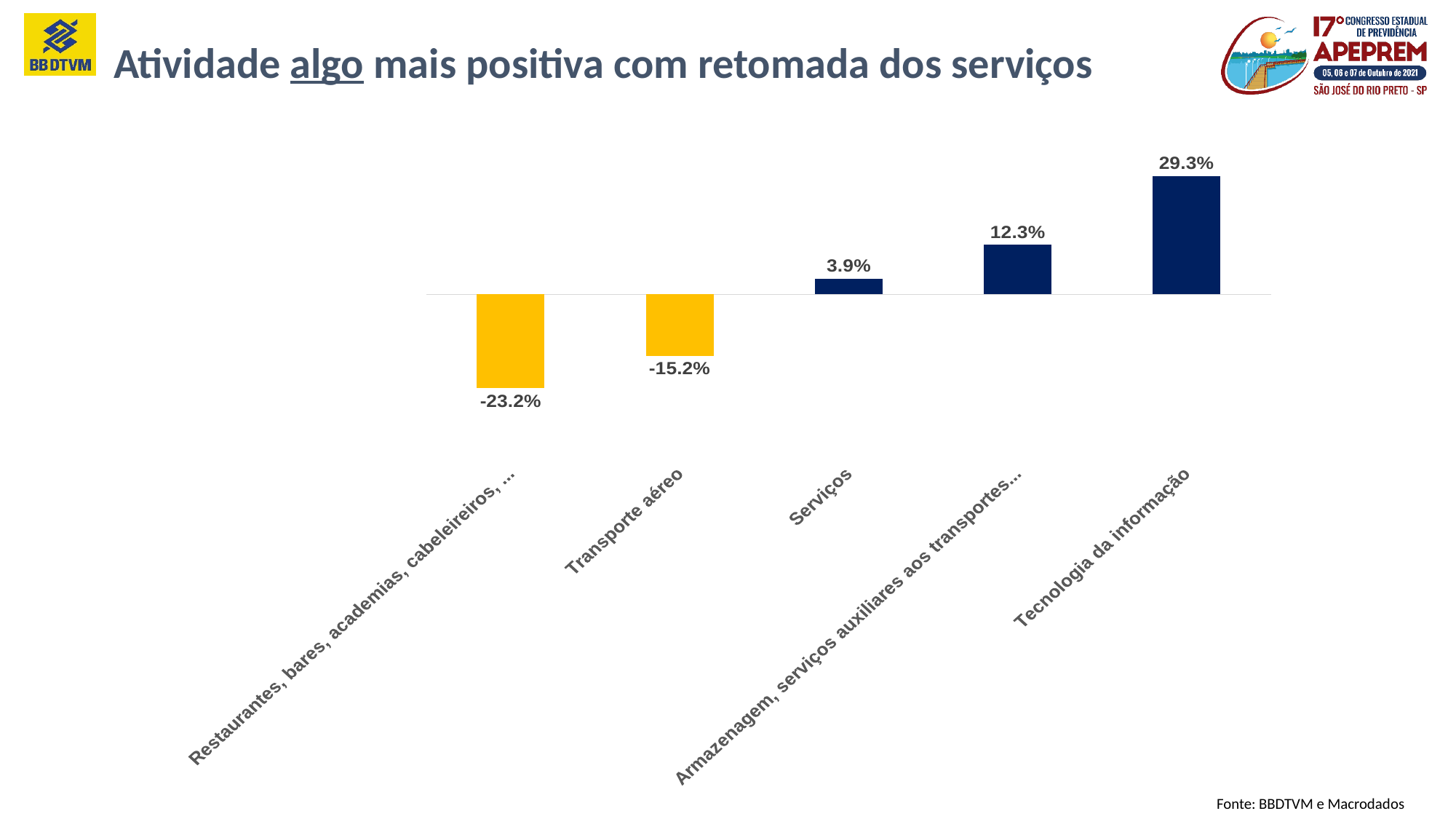
What is the difference between the values for Transporte aéreo and the Restaurantes, bares, academias, cabeleireiros bar? 8 percentage points What kind of chart is shown on the slide? Bar chart What colour are the bars with negative values? Yellow How many categories are shown in the chart? 5 What is the difference between the values for Tecnologia da informação and Serviços? 25.4 percentage points Which category has the highest value? Tecnologia da informação What is the value shown for Transporte aéreo? -15.2% What is the value shown for Tecnologia da informação? 29.3% Which is larger, the value for Serviços or the value for Armazenagem, serviços auxiliares aos transportes...? Armazenagem, serviços auxiliares aos transportes... Which category has the lowest value? Restaurantes, bares, academias, cabeleireiros, ... What is the value shown for the bar labelled Armazenagem, serviços auxiliares aos transportes...? 12.3% What is the value shown for Serviços? 3.9%